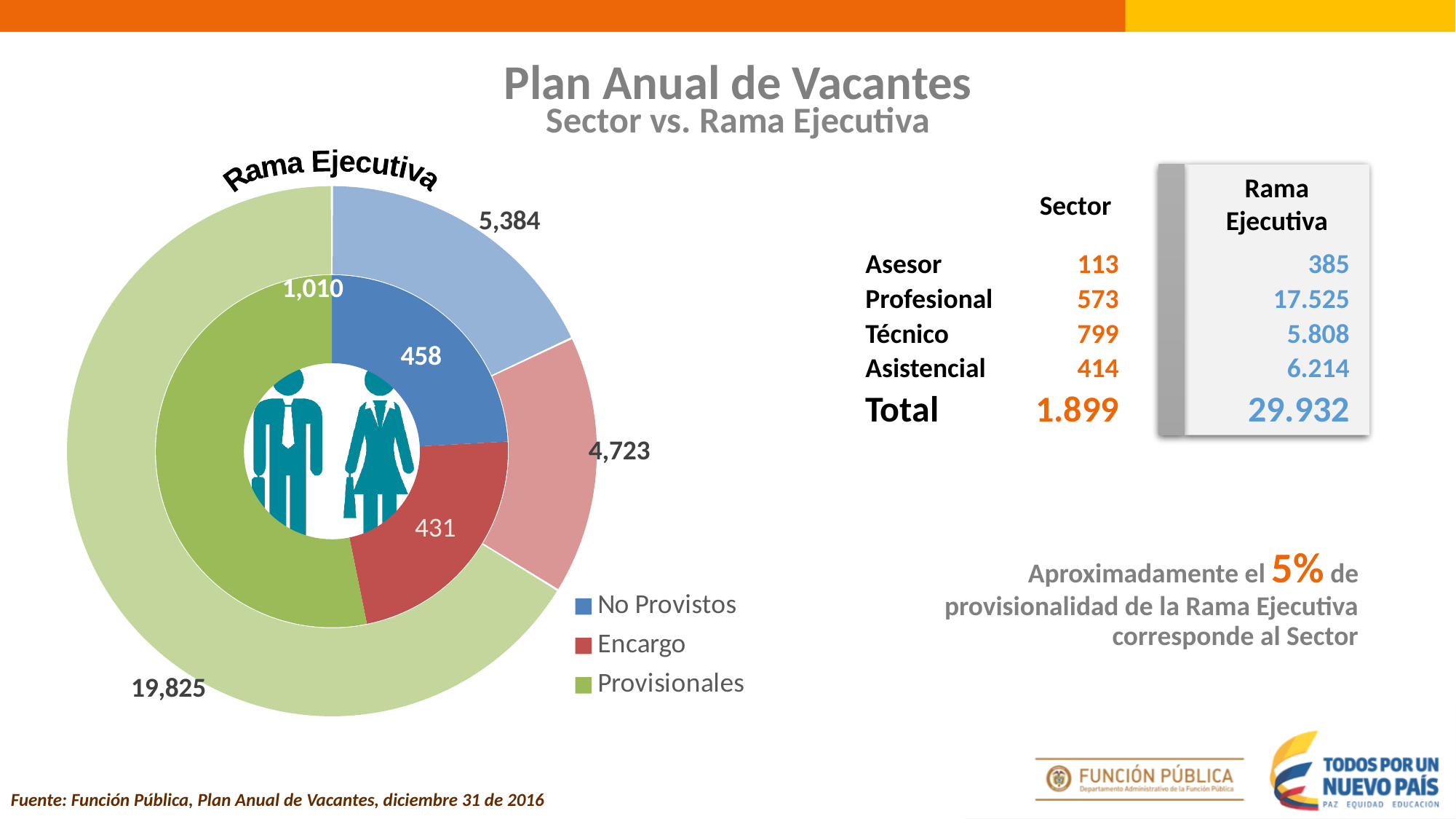
What is the total of the three values in the outer ring (Rama Ejecutiva) of the doughnut chart? 29,932 What is the value for Encargo in the outer ring (Rama Ejecutiva) of the doughnut chart? 4,723 What is the value for No Provistos in the inner ring of the doughnut chart? 458 What is the value for Provisionales in the outer ring (Rama Ejecutiva) of the doughnut chart? 19,825 In the outer ring (Rama Ejecutiva), what is the difference between the No Provistos value and the Encargo value? 661 What is the value for Encargo in the inner ring of the doughnut chart? 431 What is the value for No Provistos in the outer ring (Rama Ejecutiva) of the doughnut chart? 5,384 What kind of chart is shown on the slide? Doughnut chart What is the value for Provisionales in the inner ring of the doughnut chart? 1,010 How many entries does the chart legend list? 3 Which category has the largest value in the outer ring (Rama Ejecutiva) of the doughnut chart? Provisionales Which category has the smallest value in the outer ring (Rama Ejecutiva) of the doughnut chart? Encargo